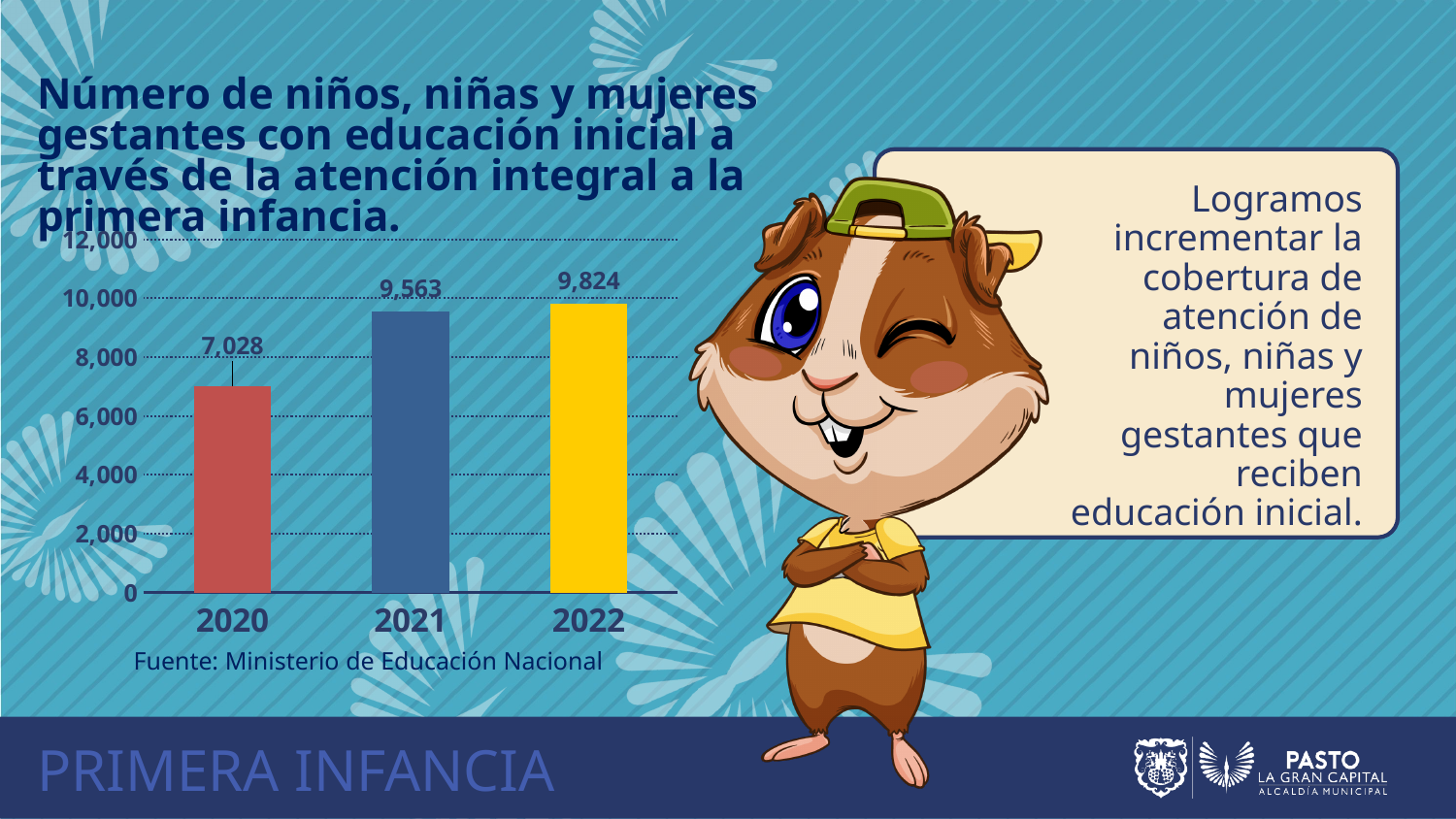
What is the difference between the values for 2022 and 2020? 2,796 Do the values rise or fall from 2020 to 2022? rise What kind of chart is shown on the slide? bar chart Which is larger, the value for 2020 or the value for 2021? 2021 How many years are shown on the chart? 3 Is the value for 2020 greater or less than 8,000? less What is the value for 2021? 9,563 Which year has the lowest value? 2020 Which year has the highest value? 2022 What is the difference between the values for 2021 and 2020? 2,535 What is the value for 2022? 9,824 What is the value for 2020? 7,028